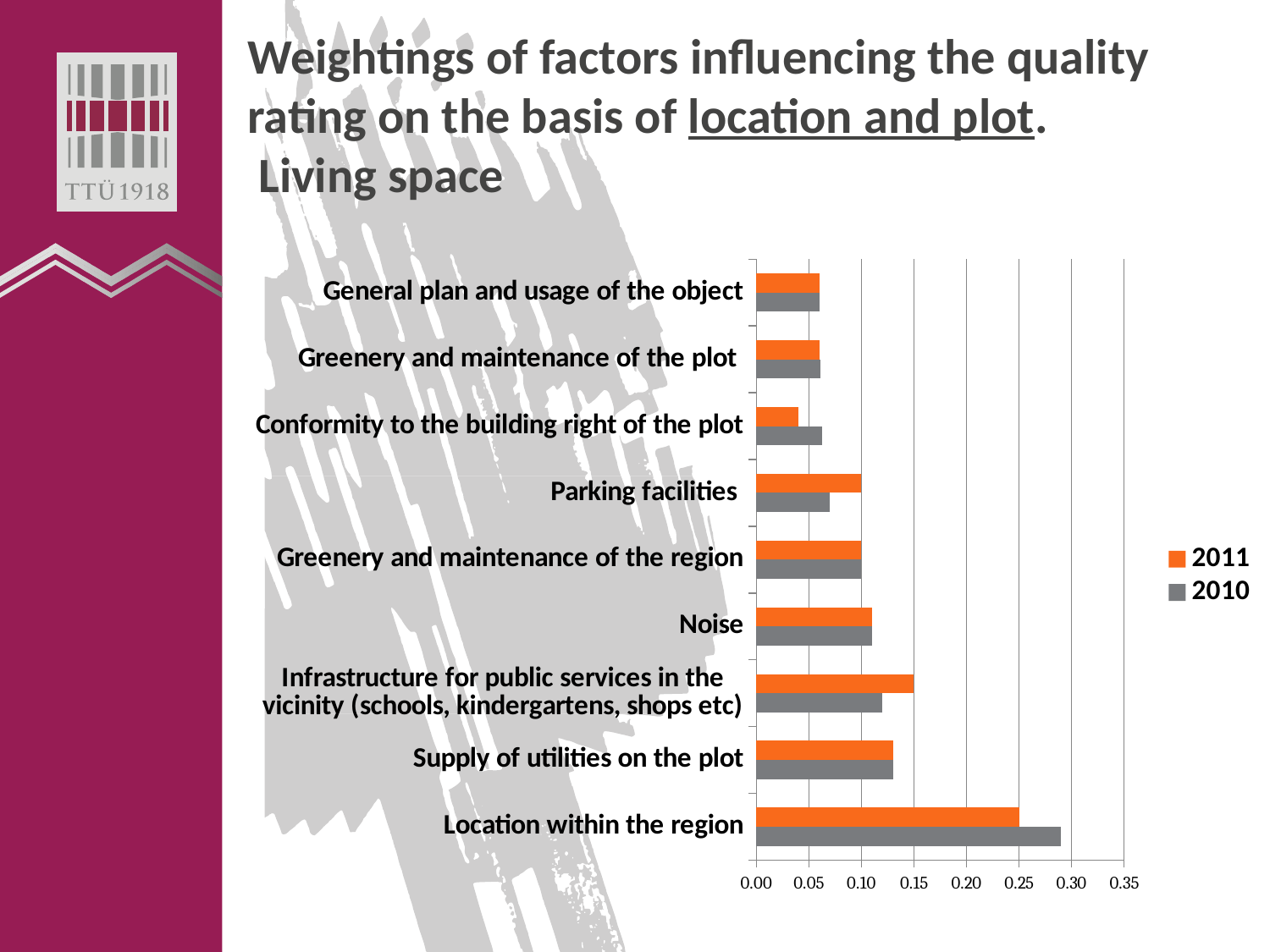
For Location within the region, which year has the larger weighting, 2010 or 2011? 2010 For Infrastructure for public services in the vicinity, which year has the larger weighting, 2010 or 2011? 2011 How many factor categories are plotted on the chart? 9 Which factor has the lowest weighting for 2011? Conformity to the building right of the plot Which colour represents the 2011 series in the legend? orange What kind of chart is shown on the slide? bar chart Is the 2010 value for Location within the region greater or less than 0.25? greater For Parking facilities, which year has the larger weighting, 2010 or 2011? 2011 Is the 2011 value for Conformity to the building right of the plot greater or less than 0.05? less Which factor has the highest weighting for 2010? Location within the region How many series does the legend list? 2 Which factor has the highest weighting for 2011? Location within the region